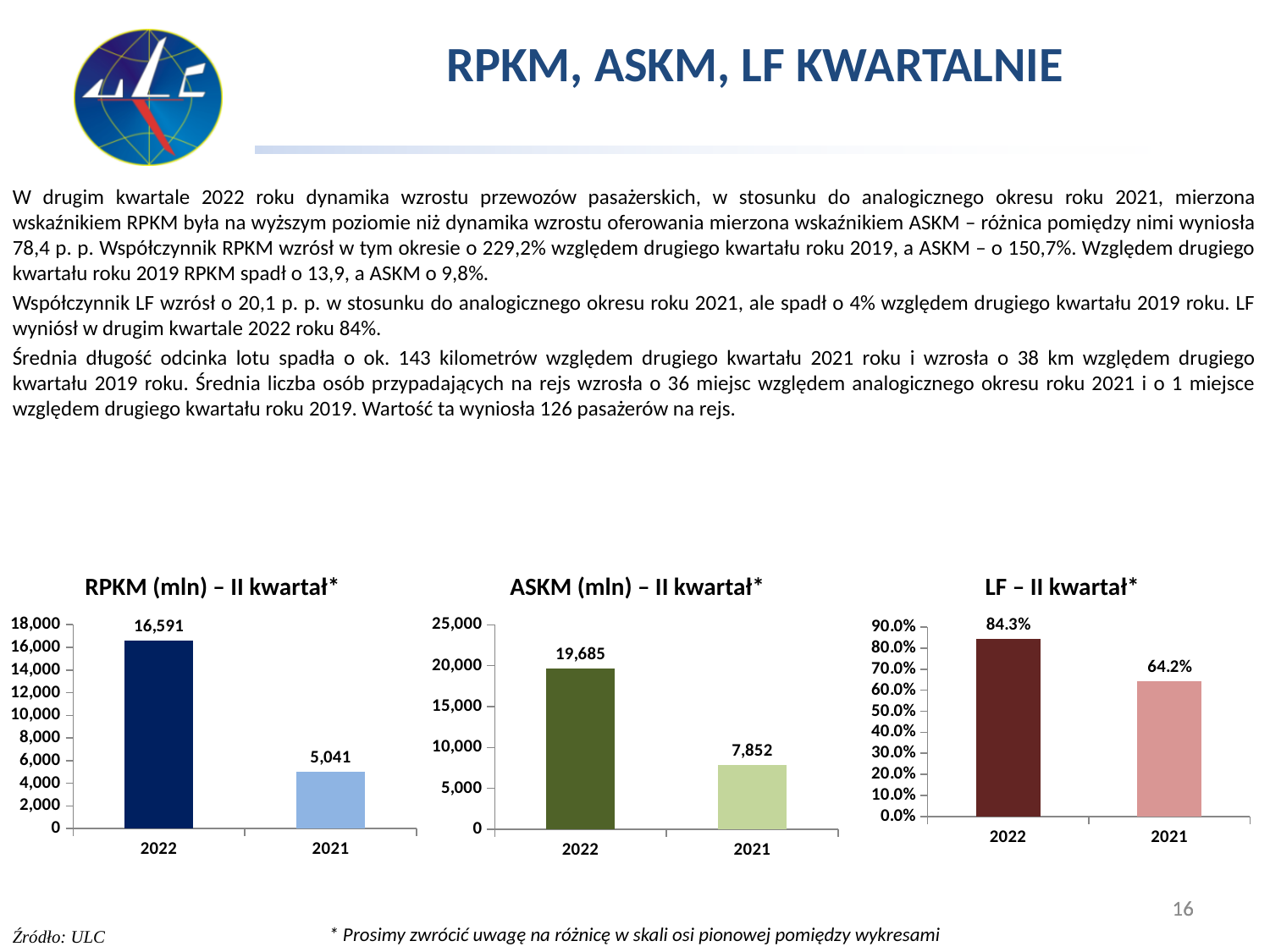
In the chart titled "RPKM (mln) – II kwartał*", what is the value for 2022? 16,591 In the chart titled "RPKM (mln) – II kwartał*", what is the difference between the 2022 and 2021 values? 11,550 In the chart titled "LF – II kwartał*", what is the value for 2022? 84.3% In the chart titled "LF – II kwartał*", which year has the lowest value? 2021 In the chart titled "ASKM (mln) – II kwartał*", which year has the higher value? 2022 In the chart titled "ASKM (mln) – II kwartał*", what is the value for 2022? 19,685 In the chart titled "RPKM (mln) – II kwartał*", what is the value for 2021? 5,041 What kind of chart is the chart titled "LF – II kwartał*"? bar chart In the chart titled "LF – II kwartał*", what is the value for 2021? 64.2% In the chart titled "ASKM (mln) – II kwartał*", is the value for 2021 greater or less than 10,000? less How many categories are shown in the chart titled "RPKM (mln) – II kwartał*"? 2 In the chart titled "ASKM (mln) – II kwartał*", what is the value for 2021? 7,852